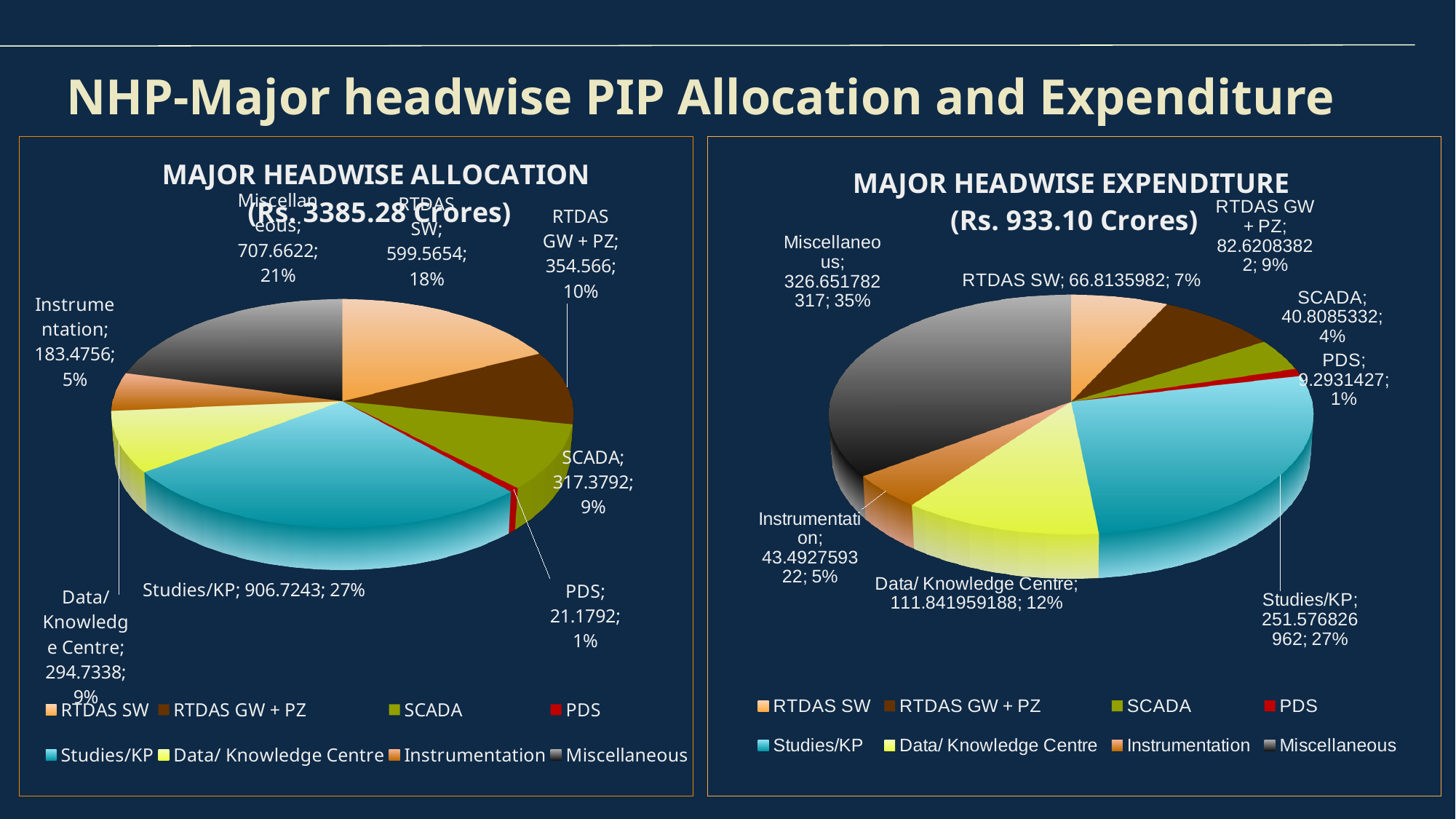
In the MAJOR HEADWISE EXPENDITURE chart, what share of the pie does SCADA represent? 4% In the MAJOR HEADWISE EXPENDITURE chart, what is the value for Data/ Knowledge Centre? 111.841959188 In the MAJOR HEADWISE ALLOCATION chart, what is the value for Studies/KP? 906.7243 How many categories does the MAJOR HEADWISE EXPENDITURE chart show? 8 In the MAJOR HEADWISE ALLOCATION chart, which category has the smallest slice? PDS In the MAJOR HEADWISE ALLOCATION chart, which category has the largest slice? Studies/KP In the MAJOR HEADWISE EXPENDITURE chart, which is larger, RTDAS SW or RTDAS GW + PZ? RTDAS GW + PZ What kind of chart is the MAJOR HEADWISE ALLOCATION chart? Pie chart In the MAJOR HEADWISE EXPENDITURE chart, what share of the pie does Miscellaneous represent? 35% In the MAJOR HEADWISE ALLOCATION chart, what is the value for Instrumentation? 183.4756 In the MAJOR HEADWISE ALLOCATION chart, what share of the pie does Miscellaneous represent? 21% What total amount in crores is given in the title of the MAJOR HEADWISE EXPENDITURE chart? Rs. 933.10 Crores